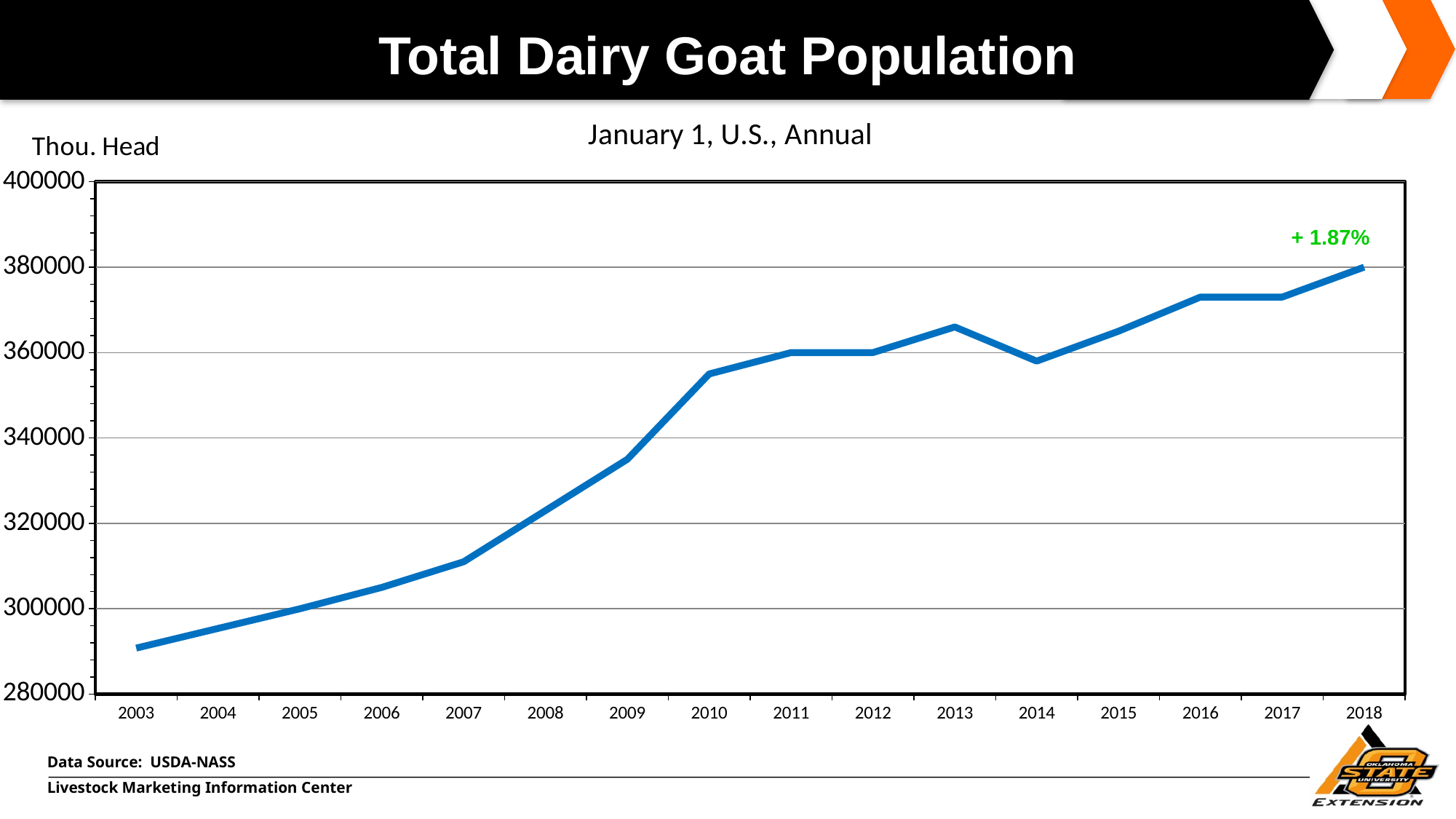
Is the value for 2003 greater or less than 300000? less What kind of chart is shown on the slide? line chart Is the value for 2007 greater or less than 300000? greater What unit label is shown above the y axis? Thou. Head What percentage change is annotated next to the 2018 point? + 1.87% Is the value for 2016 greater or less than 360000? greater Overall, does the dairy goat population rise or fall from 2003 to 2018? rise Which year has the highest total dairy goat population? 2018 Which is larger, the value for 2013 or the value for 2014? 2013 How many years are plotted on the x axis? 16 Which year has the lowest total dairy goat population? 2003